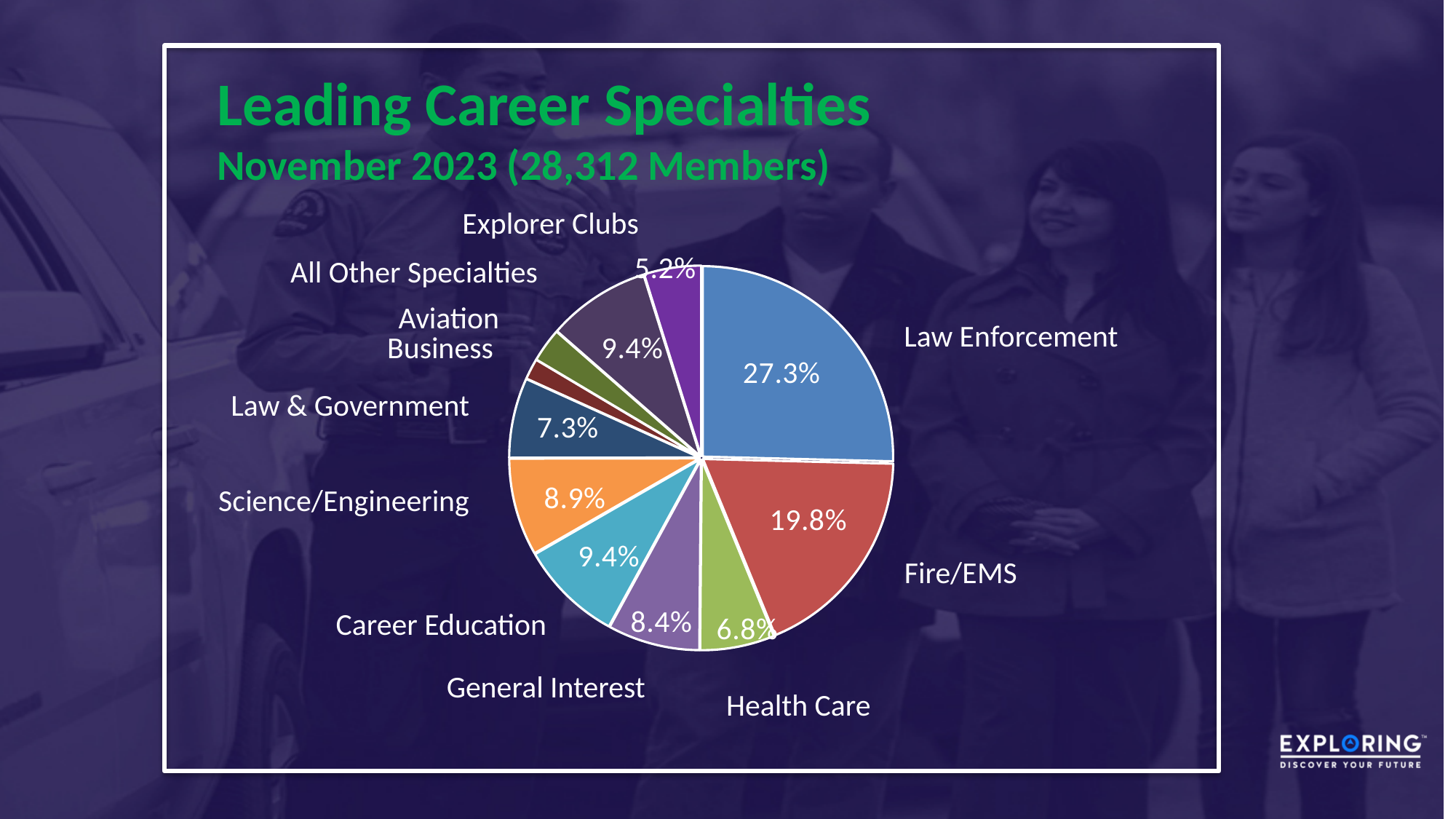
What percentage is shown for Law & Government? 7.3% Which has a larger share, Career Education or General Interest? Career Education What share of members is in Law Enforcement? 27.3% What percentage is shown for Health Care? 6.8% What is the difference in percentage points between Law Enforcement and Fire/EMS? 7.5% Which has a larger share, Health Care or Law & Government? Law & Government What kind of chart is shown on the slide? pie chart Which career specialty has the largest slice of the pie? Law Enforcement How many slices does the pie chart have? 11 What percentage is shown for Science/Engineering? 8.9% What is the title of the chart? Leading Career Specialties What percentage is shown for Fire/EMS? 19.8%